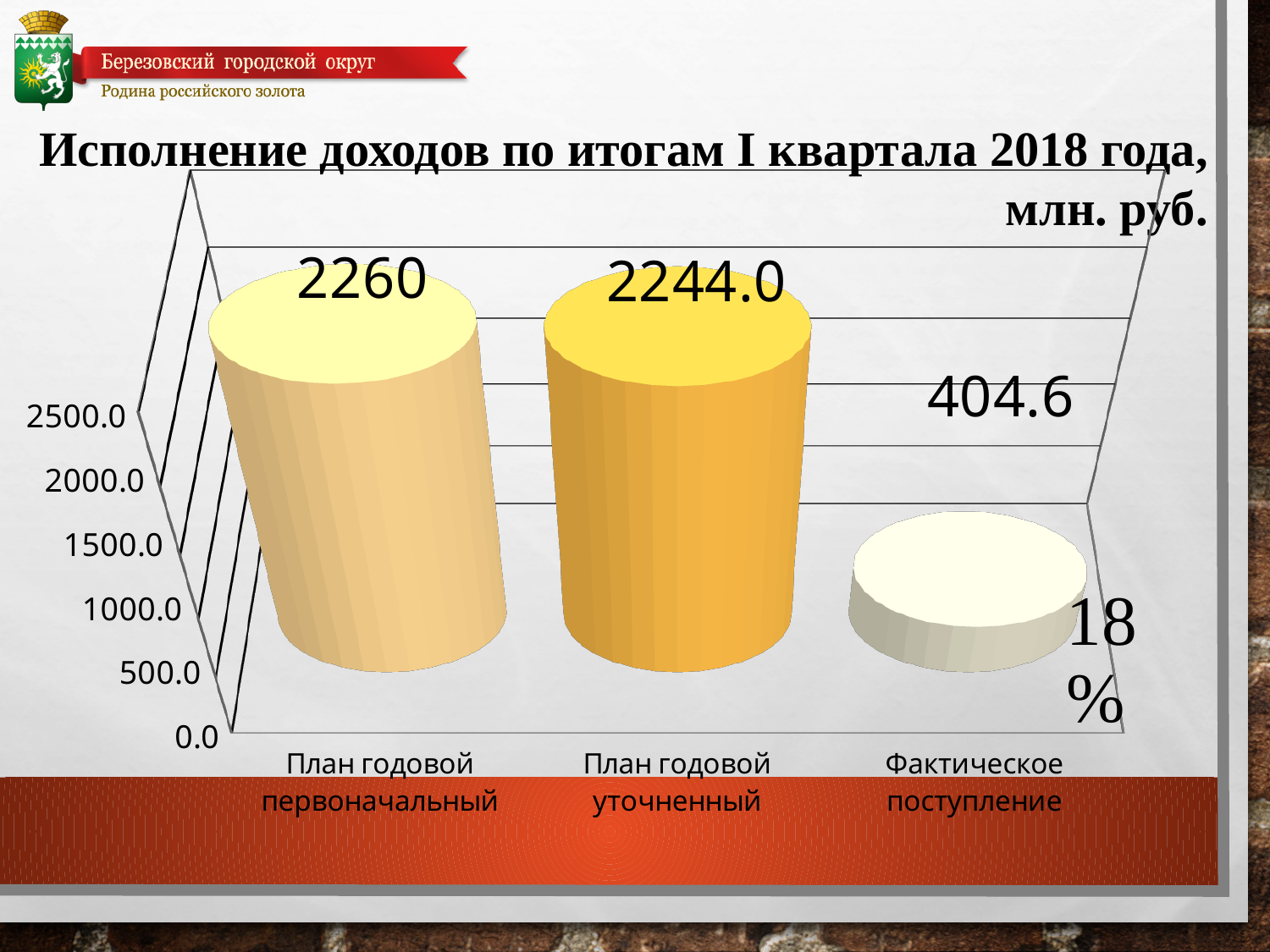
What is the difference between План годовой первоначальный and План годовой уточненный? 16.0 Which is larger: План годовой уточненный or Фактическое поступление? План годовой уточненный What kind of chart is shown on the slide? bar chart What is the value for План годовой первоначальный? 2260 What percentage is printed next to the Фактическое поступление bar? 18% What is the value for План годовой уточненный? 2244.0 Is the value for Фактическое поступление greater or less than 500.0? less What is the difference between План годовой уточненный and Фактическое поступление? 1839.4 Which category has the lowest value? Фактическое поступление What is the value for Фактическое поступление? 404.6 Which category has the highest value? План годовой первоначальный How many categories are shown on the chart? 3